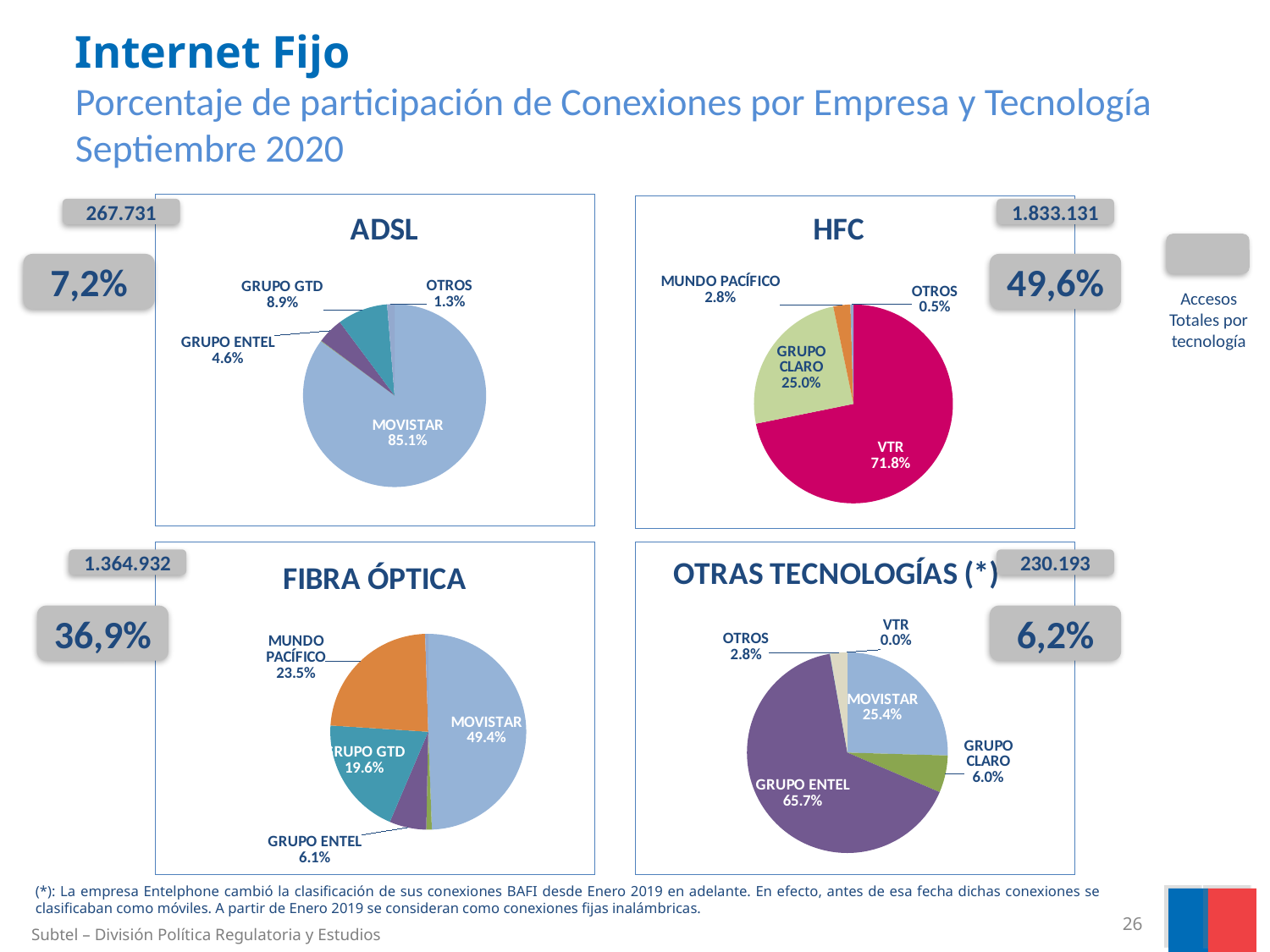
What is the total number of accesses shown for the HFC technology? 1.833.131 In the FIBRA ÓPTICA chart, which is larger, the share of GRUPO GTD or the share of GRUPO ENTEL? GRUPO GTD In the HFC chart, what is the difference between the shares of VTR and GRUPO CLARO? 46.8% In the ADSL chart, what share does MOVISTAR hold? 85.1% In the OTRAS TECNOLOGÍAS (*) chart, what is the share of VTR? 0.0% How many categories are shown in the HFC chart? 4 In the HFC chart, what is the share of GRUPO CLARO? 25.0% In the HFC chart, which company has the largest share? VTR In the FIBRA ÓPTICA chart, what share does MUNDO PACÍFICO hold? 23.5% What type of chart is used for the ADSL data? Pie chart In the OTRAS TECNOLOGÍAS (*) chart, what is the share of GRUPO ENTEL? 65.7%